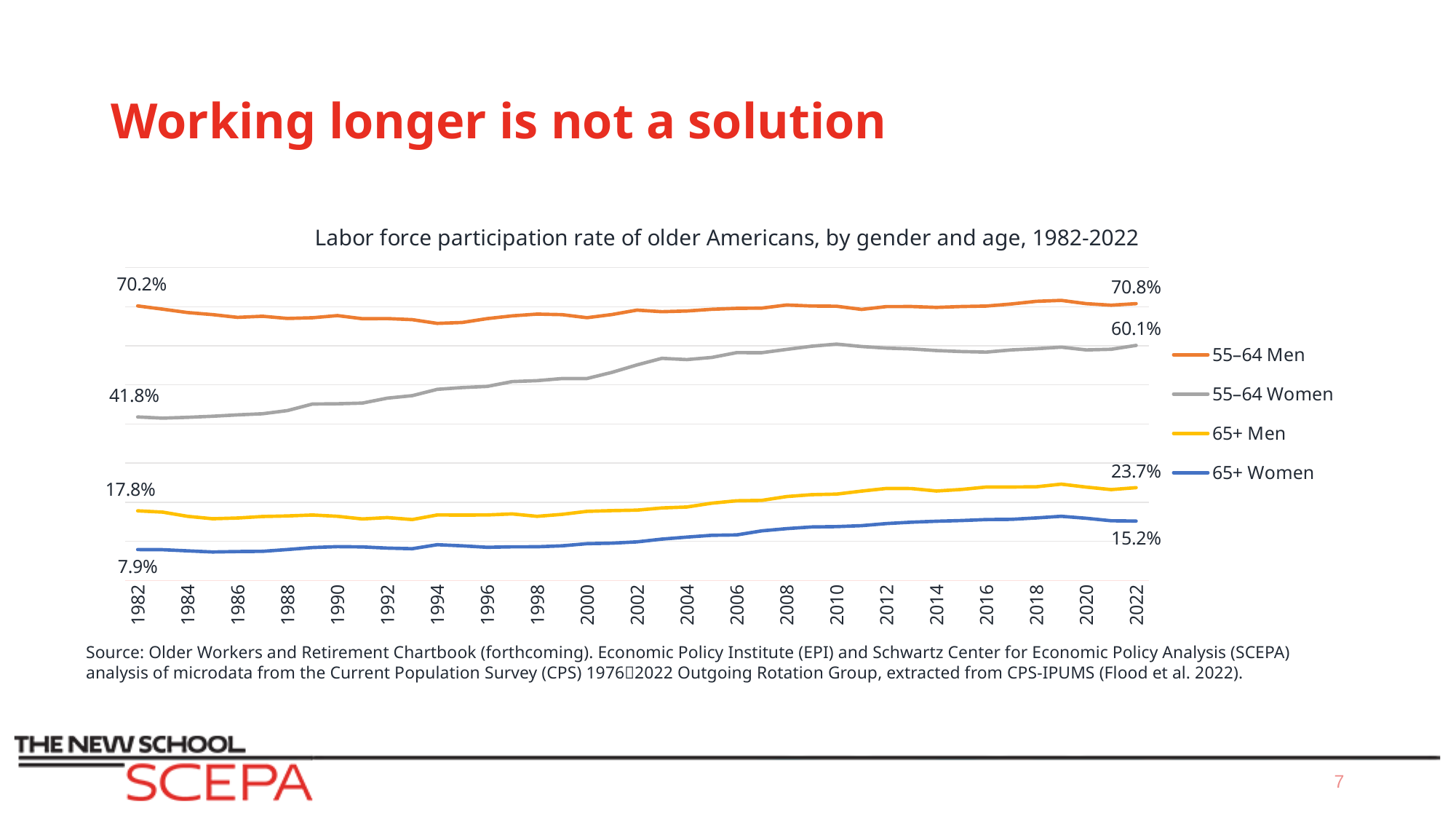
By how many percentage points did the participation rate for 65+ Women change between 1982 and 2022? 7.3 percentage points In 2022, which was larger: the participation rate for 65+ Men or for 65+ Women? 65+ Men By how many percentage points did the participation rate for 55–64 Women change between 1982 and 2022? 18.3 percentage points What was the labor force participation rate for 65+ Men in 2022? 23.7% How many series does the legend list? 4 Does the participation rate for 55–64 Women rise or fall from 1982 to 2022? rise What was the labor force participation rate for 65+ Women in 1982? 7.9% Which group had the lowest labor force participation rate in 1982? 65+ Women What kind of chart is shown on the slide? line chart What was the labor force participation rate for 55–64 Women in 2022? 60.1% What was the labor force participation rate for 55–64 Men in 1982? 70.2% Which group had the highest labor force participation rate in 2022? 55–64 Men